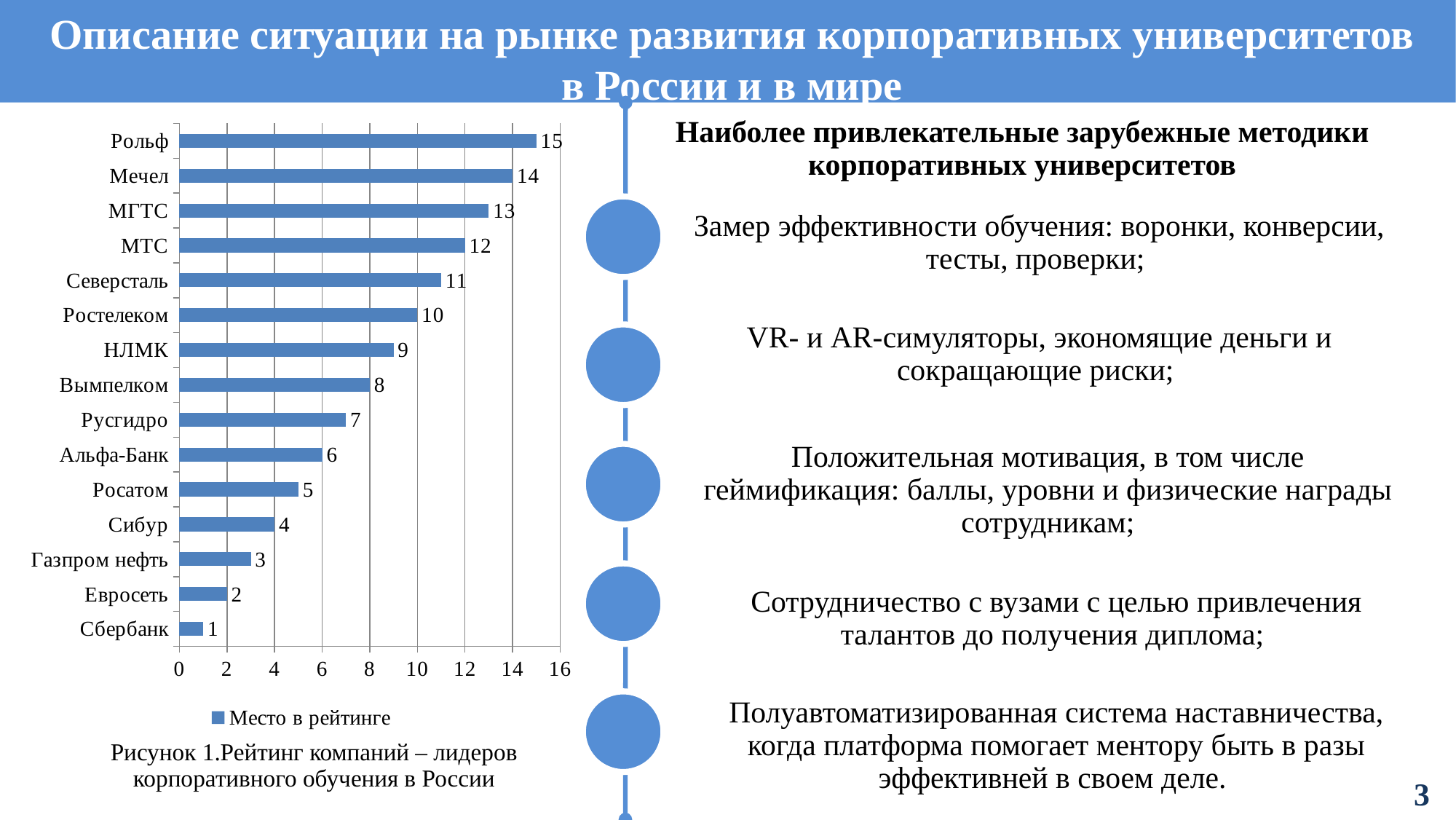
What is the legend entry of the chart? Место в рейтинге Which company has the lowest value in the chart? Сбербанк What kind of chart is shown on the slide? bar chart What is the value for Рольф in the chart? 15 Which has a larger value, Ростелеком or Вымпелком? Ростелеком How many series does the chart legend list? 1 What is the value for Сбербанк in the chart? 1 What is the value for Северсталь in the chart? 11 Which company has the highest value in the chart? Рольф How many companies are shown in the chart? 15 What is the difference between the values for МТС and Росатом? 7 Is the value for Мечел greater or less than 10? greater